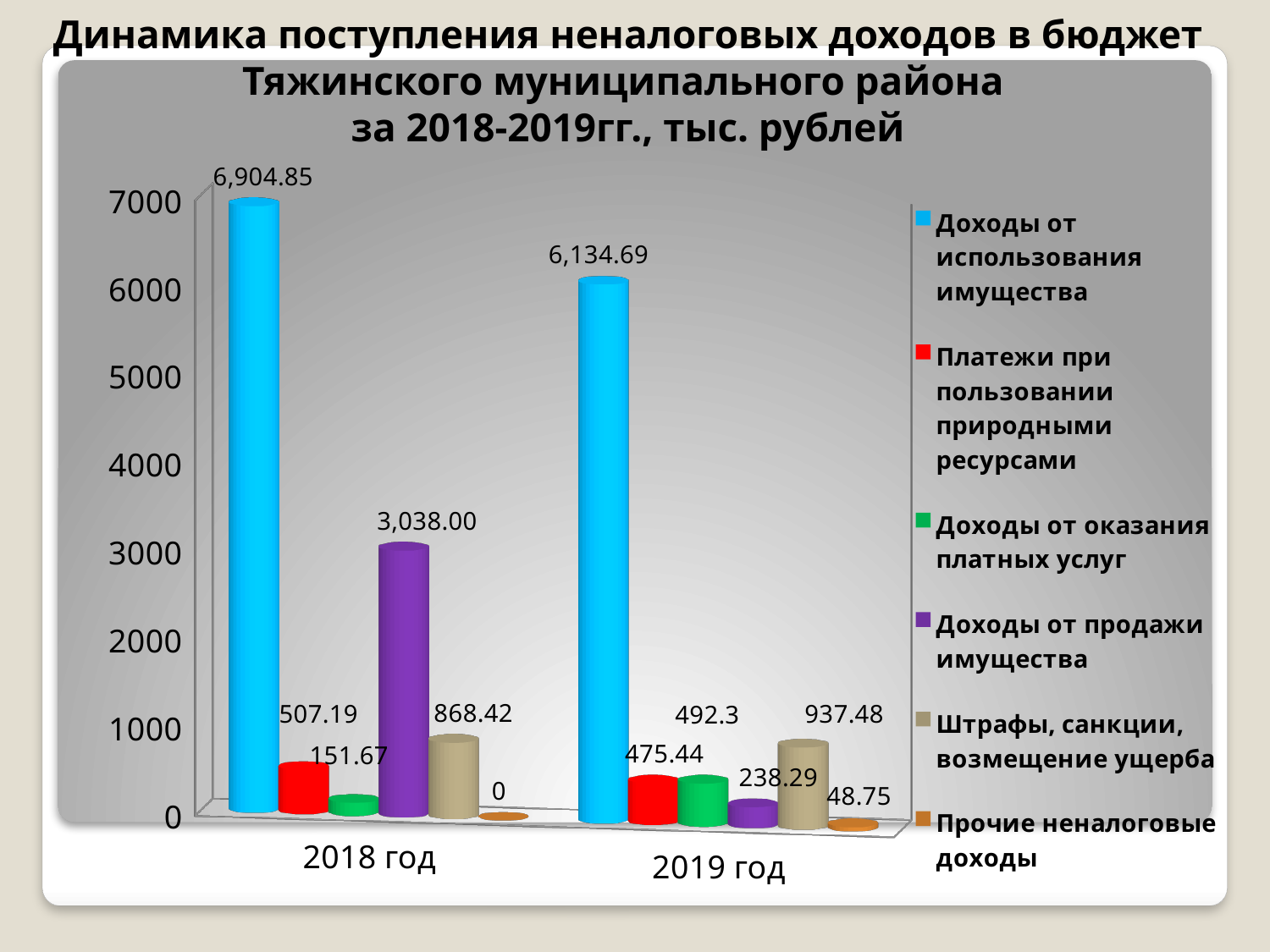
What is the value of 'Штрафы, санкции, возмещение ущерба' for 2019 год? 937.48 What is the value of 'Доходы от использования имущества' for 2018 год? 6,904.85 What is the value of 'Доходы от продажи имущества' for 2019 год? 238.29 How many series does the legend list? 6 Which series has the highest value in 2019 год? Доходы от использования имущества Which series has the lowest value in 2018 год? Прочие неналоговые доходы Did 'Доходы от продажи имущества' rise or fall from 2018 год to 2019 год? fall Which is larger: 'Доходы от оказания платных услуг' in 2018 год or in 2019 год? 2019 год How many year categories are shown on the x axis? 2 By how much did 'Доходы от использования имущества' decrease from 2018 год to 2019 год? 770.16 What is the value of 'Прочие неналоговые доходы' for 2018 год? 0 What type of chart is shown on the slide? bar chart